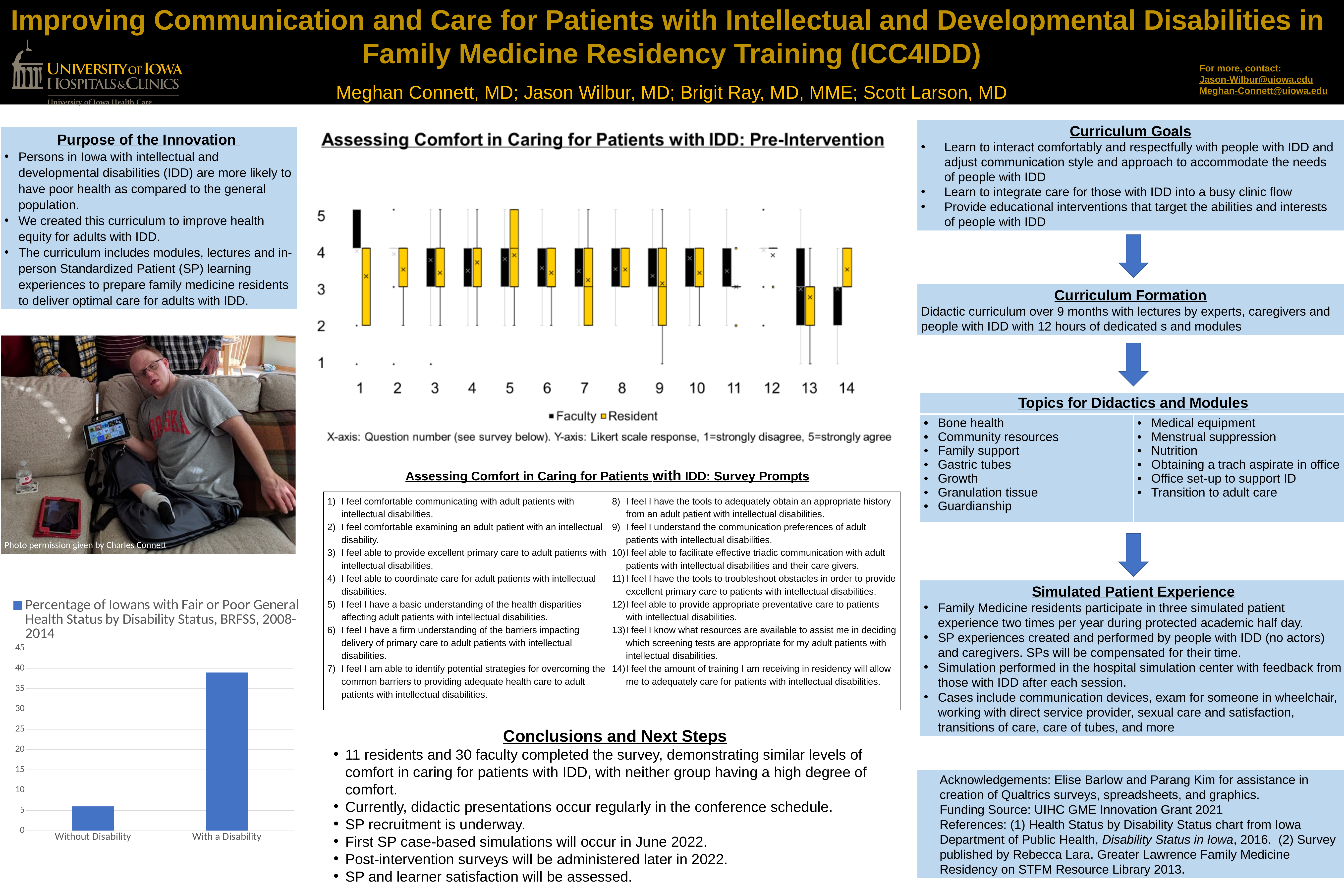
In the bar chart at the bottom left, is the value for Without Disability greater or less than 10? less In the bar chart at the bottom left, is the value for With a Disability greater or less than 35? greater In the bar chart at the bottom left, what is the highest value shown on the y axis? 45 What is the title of the bar chart at the bottom left, as shown in its legend? Percentage of Iowans with Fair or Poor General Health Status by Disability Status, BRFSS, 2008-2014 How many series does the legend list in the chart titled 'Assessing Comfort in Caring for Patients with IDD: Pre-Intervention'? 2 How many categories are shown on the x axis of the bar chart at the bottom left? 2 In the bar chart at the bottom left, which category has the lowest value? Without Disability How many question numbers are shown on the x axis of the chart titled 'Assessing Comfort in Caring for Patients with IDD: Pre-Intervention'? 14 What kind of chart is the chart titled 'Assessing Comfort in Caring for Patients with IDD: Pre-Intervention'? box plot In the chart titled 'Assessing Comfort in Caring for Patients with IDD: Pre-Intervention', which series is shown in yellow? Resident What kind of chart is the chart at the bottom left of the slide? bar chart In the bar chart at the bottom left, which category has the higher value, Without Disability or With a Disability? With a Disability